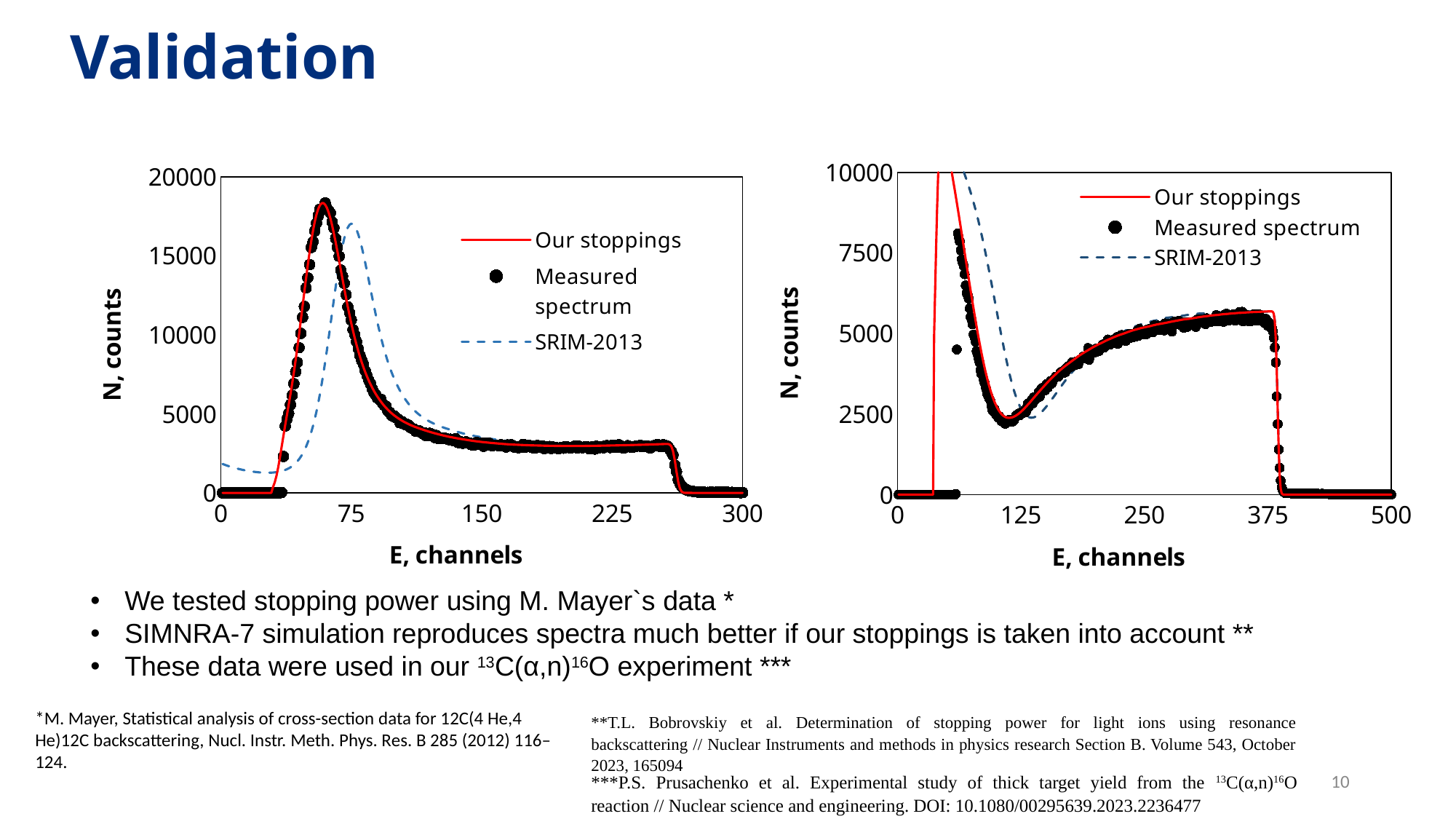
How many series does the legend of the right chart list? 3 In the left chart, is the peak value of the measured spectrum greater or less than 15000? greater What is the x-axis label of the left chart? E, channels In the right chart, which series is drawn as a dashed line? SRIM-2013 What kind of chart is the left chart on the slide? line chart How many series does the legend of the left chart list? 3 In the left chart, is the measured spectrum value at channel 200 greater or less than 5000? less In the left chart, does the measured spectrum rise or fall between channel 75 and channel 150? fall In the right chart, is the measured spectrum value at channel 250 greater or less than 2500? greater In the right chart, does the measured spectrum rise or fall between channel 125 and channel 375? rise